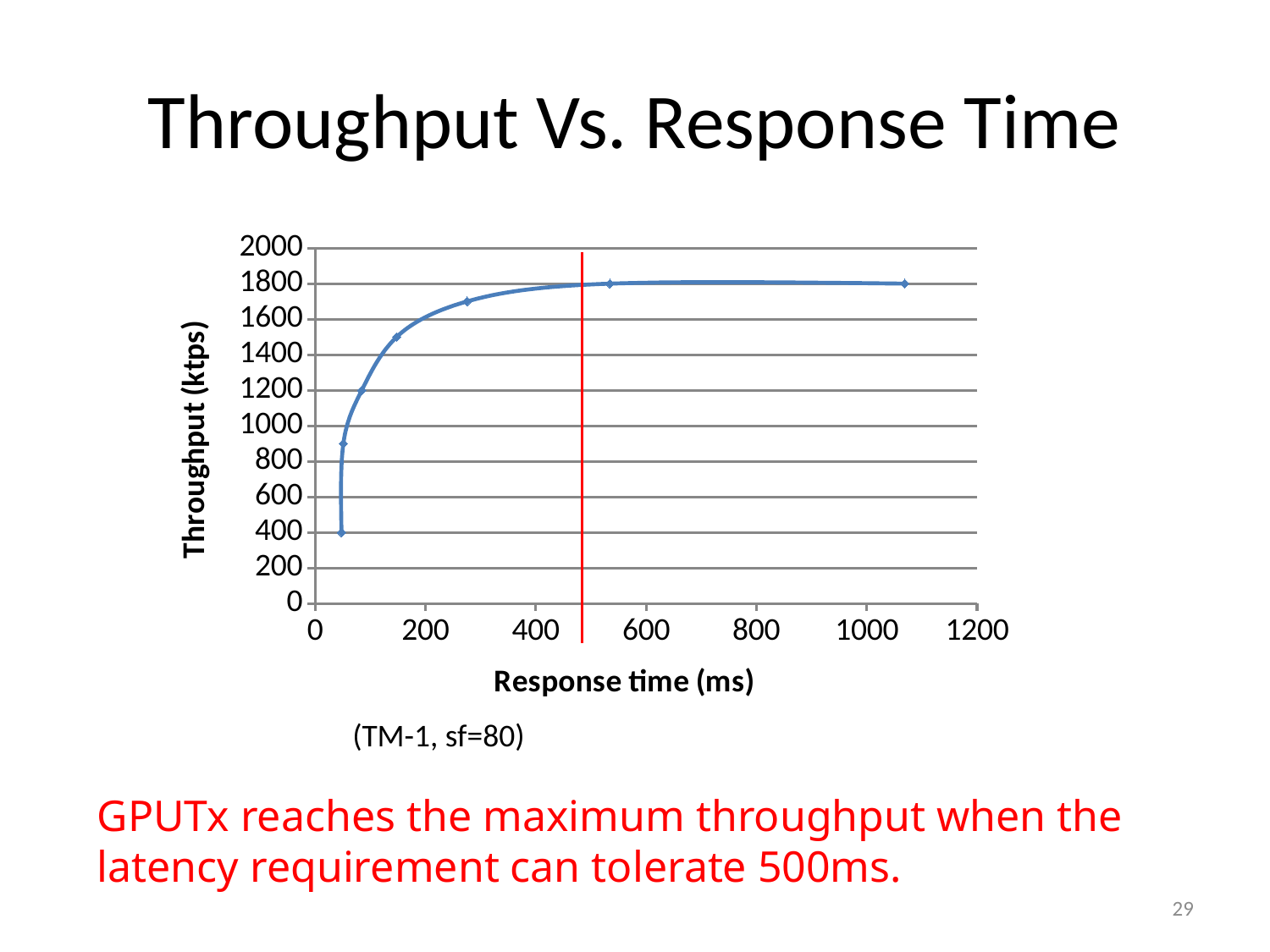
What is the label of the x axis? Response time (ms) What is the highest value shown on the x axis? 1200 What kind of chart is shown on the slide? line chart Is the lowest throughput value plotted greater or less than 600 ktps? less What is the label of the y axis? Throughput (ktps) Is the throughput at the point with response time just above 500 ms greater or less than 1600 ktps? greater Is the response time of the lowest-throughput point greater or less than 200 ms? less Does throughput rise or fall as response time increases along the x axis? rises, then levels off Which has higher throughput: the point at about 1070 ms response time or the point at about 50 ms response time with the lowest throughput? the point at about 1070 ms